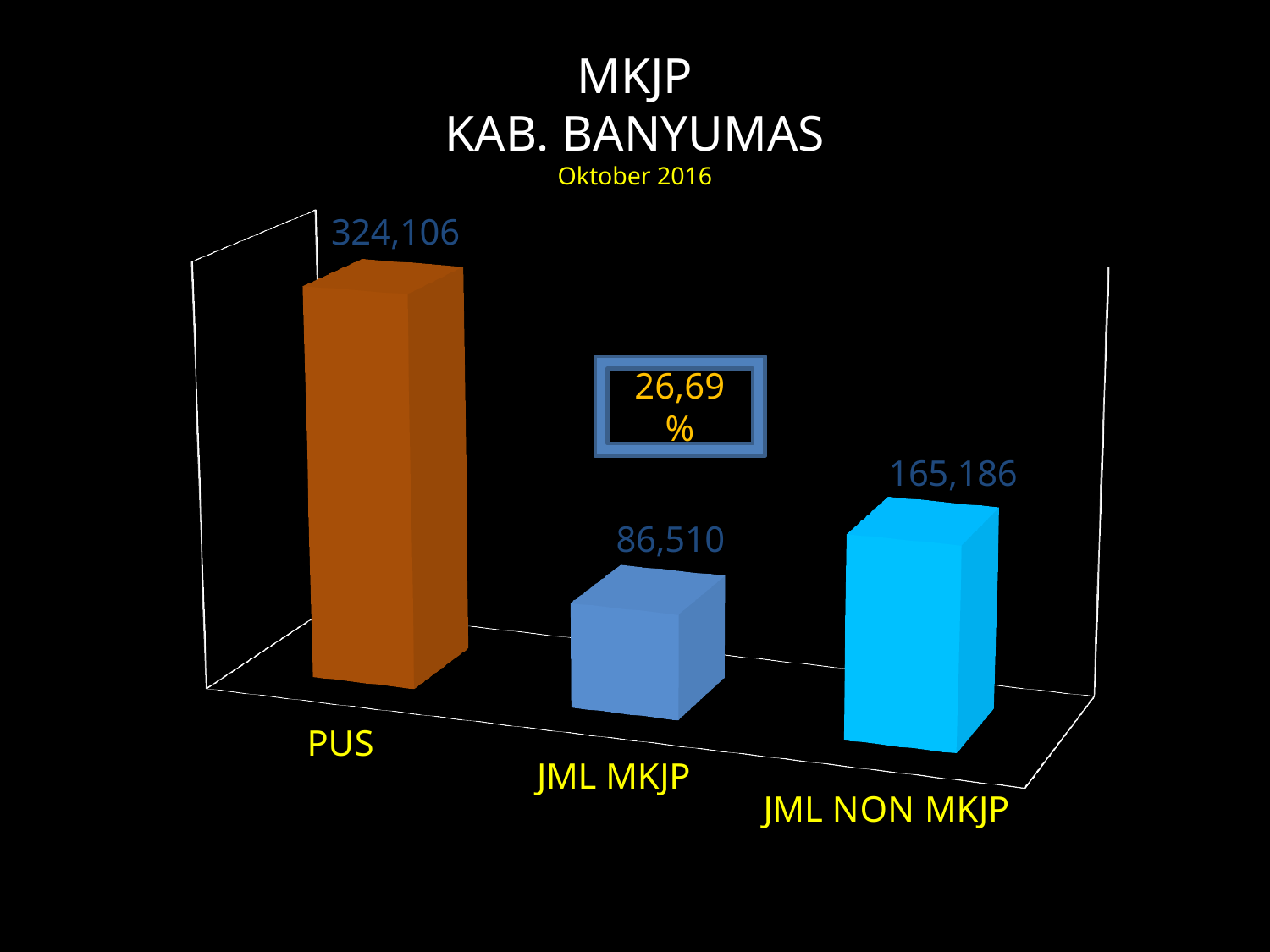
What percentage is shown in the box in the middle of the chart? 26,69 % What is the difference between the values for JML NON MKJP and JML MKJP? 78,676 Which category has the highest value? PUS Which is larger, the value for JML MKJP or the value for JML NON MKJP? JML NON MKJP Which category has the lowest value? JML MKJP What is the difference between the values for PUS and JML NON MKJP? 158,920 What is the value for PUS? 324,106 What kind of chart is shown on the slide? bar chart What is the value for JML NON MKJP? 165,186 What is the value for JML MKJP? 86,510 How many categories are shown in the chart? 3 What month and year does the chart subtitle give? Oktober 2016